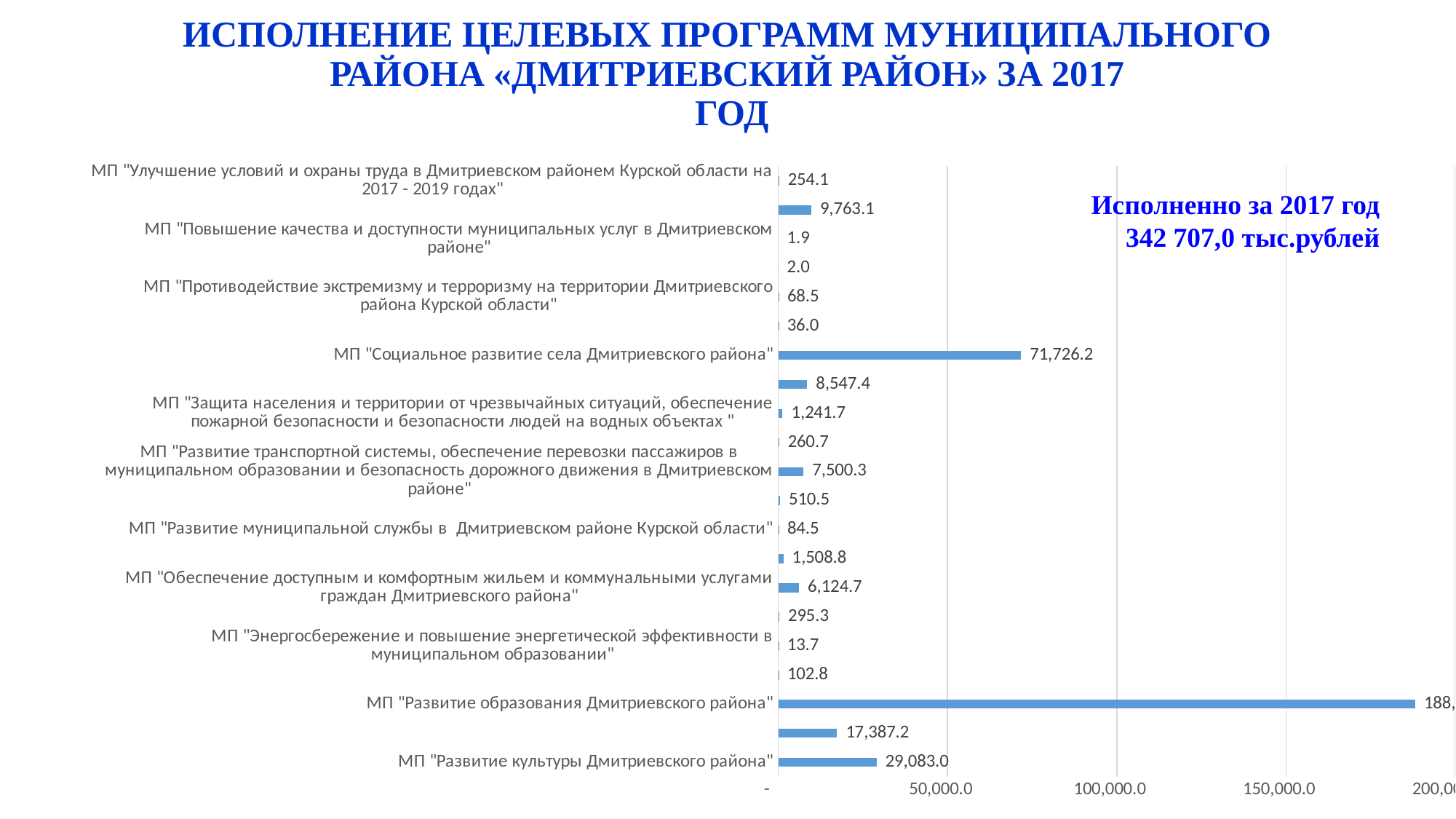
What type of chart is shown on the slide? bar chart What is the value for МП "Развитие транспортной системы, обеспечение перевозки пассажиров в муниципальном образовании и безопасность дорожного движения в Дмитриевском районе"? 7,500.3 What is the value for МП "Обеспечение доступным и комфортным жильем и коммунальными услугами граждан Дмитриевского района"? 6,124.7 What is the value for МП "Развитие муниципальной службы в Дмитриевском районе Курской области"? 84.5 Is the value for МП "Развитие образования Дмитриевского района" greater or less than 150,000.0? greater Which is larger: the value for МП "Социальное развитие села Дмитриевского района" or МП "Развитие культуры Дмитриевского района"? МП "Социальное развитие села Дмитриевского района" How many bars are plotted in the chart? 21 What is the value for МП "Социальное развитие села Дмитриевского района"? 71,726.2 What is the value for МП "Развитие культуры Дмитриевского района"? 29,083.0 Which labeled program has the highest value? МП "Развитие образования Дмитриевского района" What is the difference between the values for МП "Социальное развитие села Дмитриевского района" and МП "Развитие культуры Дмитриевского района"? 42,643.2 What is the value for МП "Энергосбережение и повышение энергетической эффективности в муниципальном образовании"? 13.7